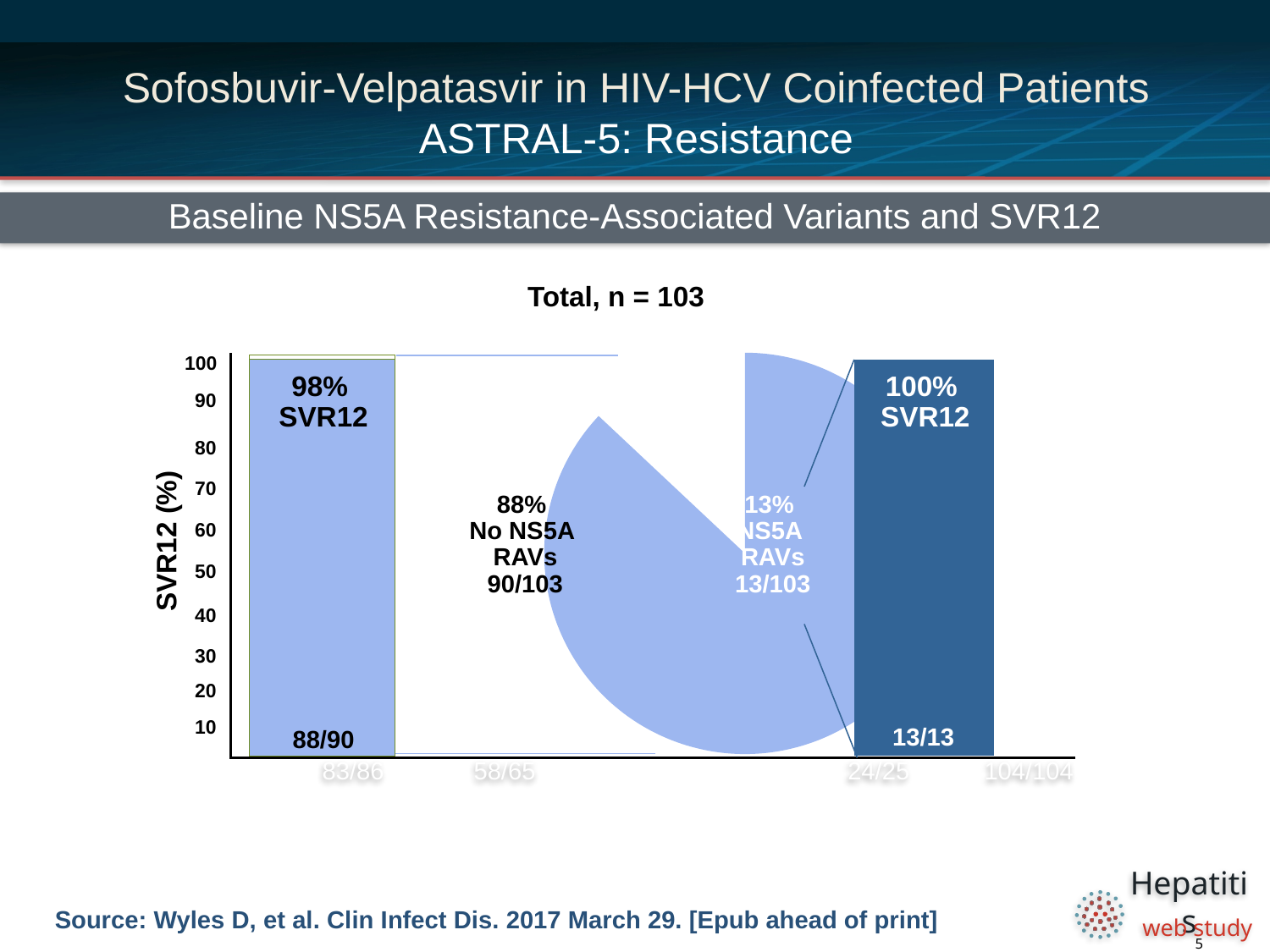
In the bar chart, what fraction of patients is printed at the bottom of the left bar? 88/90 In the bar chart, what fraction of patients is printed at the bottom of the right bar? 13/13 In the pie chart, what percentage of patients had no NS5A RAVs at baseline? 88% In the bar chart, what is the difference in SVR12 rate between the right bar (100%) and the left bar (98%)? 2 percentage points In the pie chart, what percentage of patients had NS5A RAVs at baseline? 13% In the bar chart, what SVR12 rate is shown for the right bar (patients with NS5A RAVs)? 100% In the bar chart, what SVR12 rate is shown for the left bar (patients with no NS5A RAVs)? 98% In the pie chart, how many of the 103 patients had NS5A RAVs? 13/103 What is the total number of patients stated above the charts? Total, n = 103 In the bar chart, which bar shows the higher SVR12 rate: the left bar (no NS5A RAVs) or the right bar (NS5A RAVs)? The right bar (NS5A RAVs) In the pie chart, which slice is larger: No NS5A RAVs or NS5A RAVs? No NS5A RAVs In the pie chart, how many of the 103 patients had no NS5A RAVs? 90/103